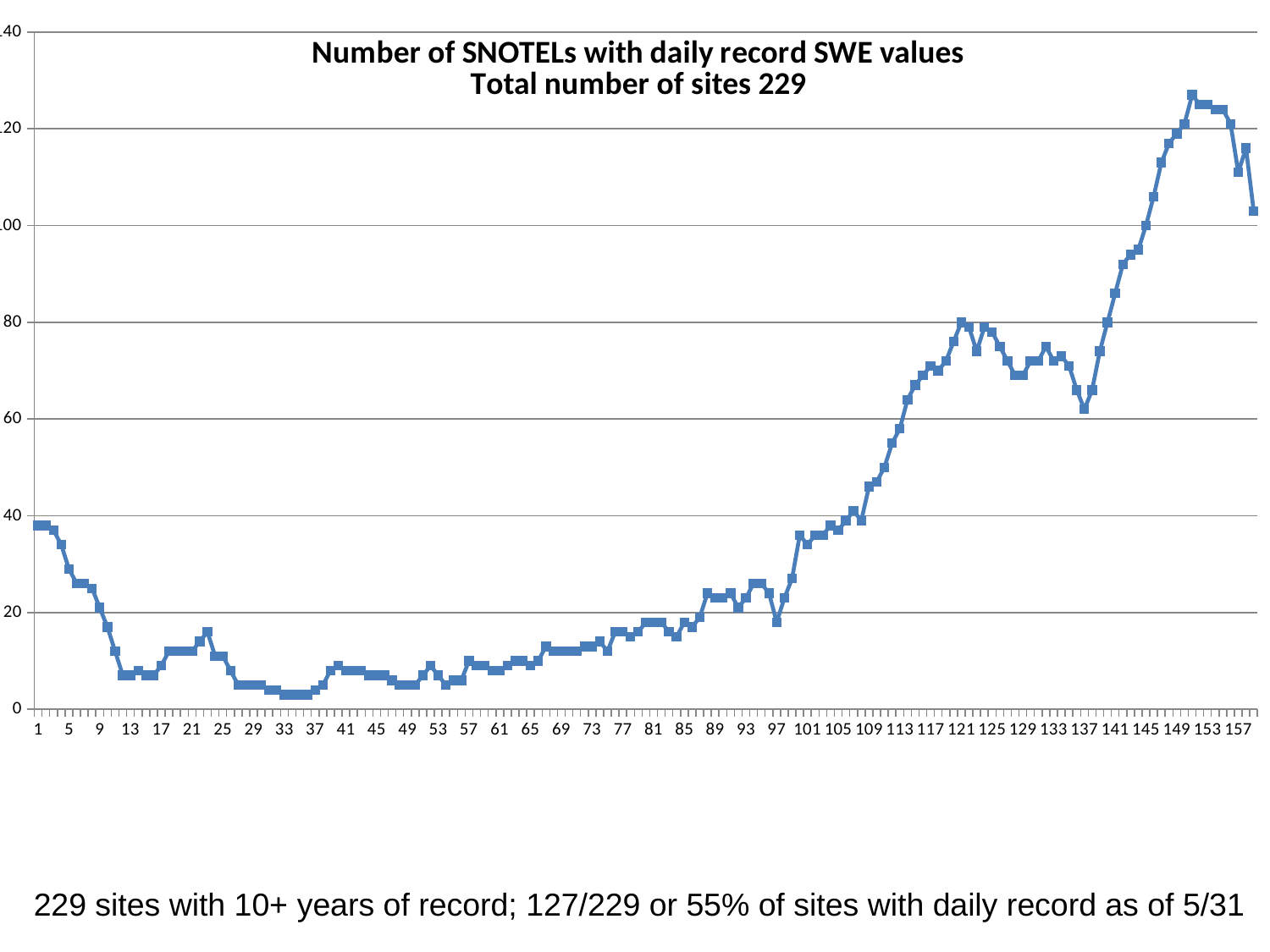
Is the value at x = 97 greater or less than 40? less What kind of chart is shown on the slide? line chart Is the value at x = 33 greater or less than 20? less Is the value at x = 1 greater or less than 20? greater Overall, do the values rise or fall from the left of the x axis to the right? rise Which is larger, the value at x = 61 or the value at x = 89? x = 89 Which is larger, the value at x = 121 or the value at x = 137? x = 121 What is the title of the chart? Number of SNOTELs with daily record SWE values Total number of sites 229 Between x = 1 and x = 13, do the values rise or fall? fall Between x = 137 and x = 151, do the values rise or fall? rise